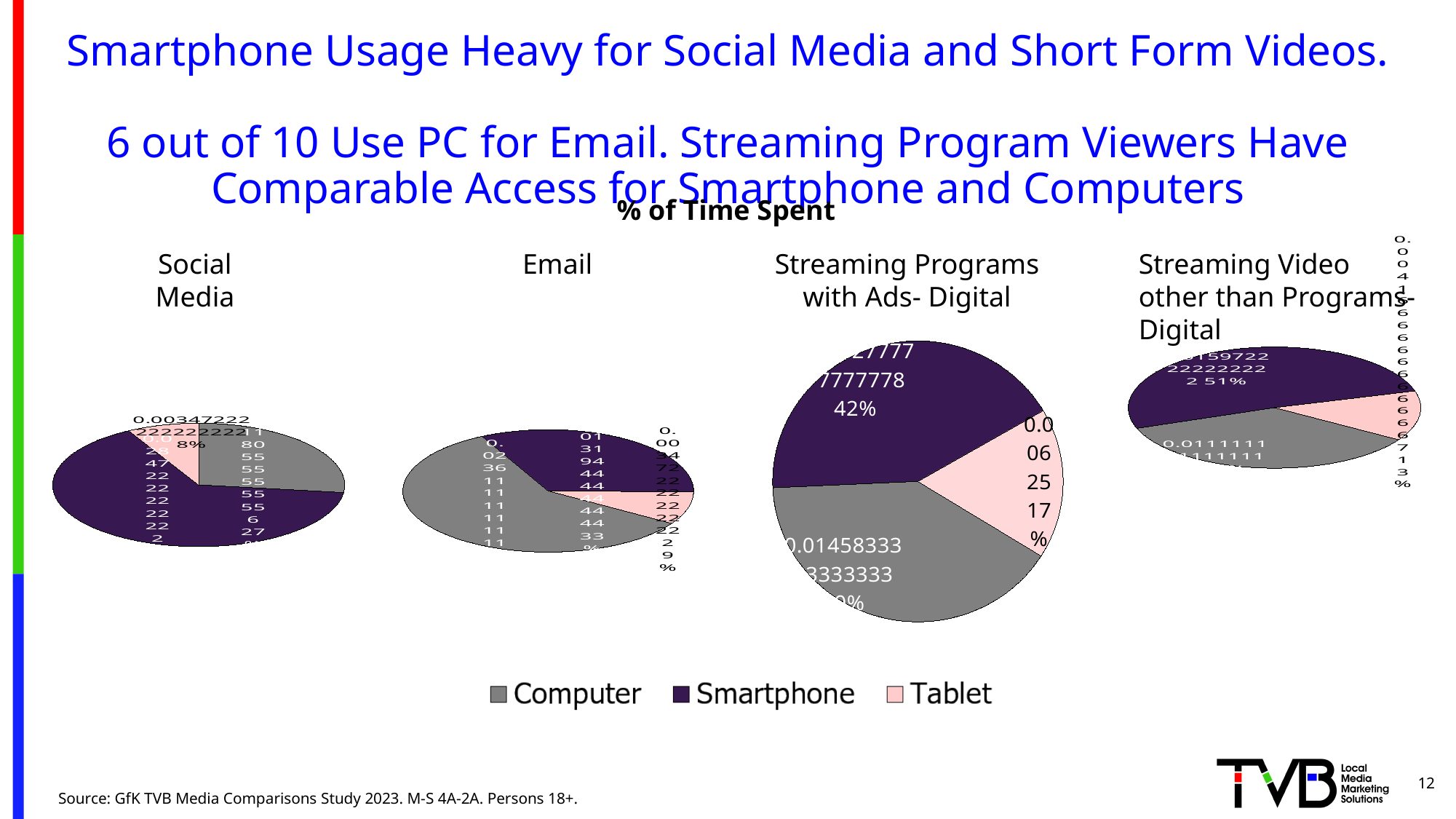
In the Email pie, which device has the largest share of time spent? Computer What is the title shown above the pie charts? % of Time Spent How many pie charts are on the slide? 4 In the Streaming Video other than Programs- Digital pie, what share of time is spent on Smartphone? 51% How many series does the legend list? 3 In the Streaming Programs with Ads- Digital pie, how many percentage points larger is the Smartphone share than the Tablet share? 25 percentage points What are the three entries in the legend? Computer, Smartphone, Tablet In the Streaming Programs with Ads- Digital pie, what share of time is spent on Tablet? 17% In the Social Media pie, which device has the largest share of time spent? Smartphone In the Streaming Programs with Ads- Digital pie, what share of time is spent on Smartphone? 42% In the Streaming Programs with Ads- Digital pie, which is larger, the Smartphone share or the Tablet share? Smartphone What kind of charts are shown on the slide? Pie charts